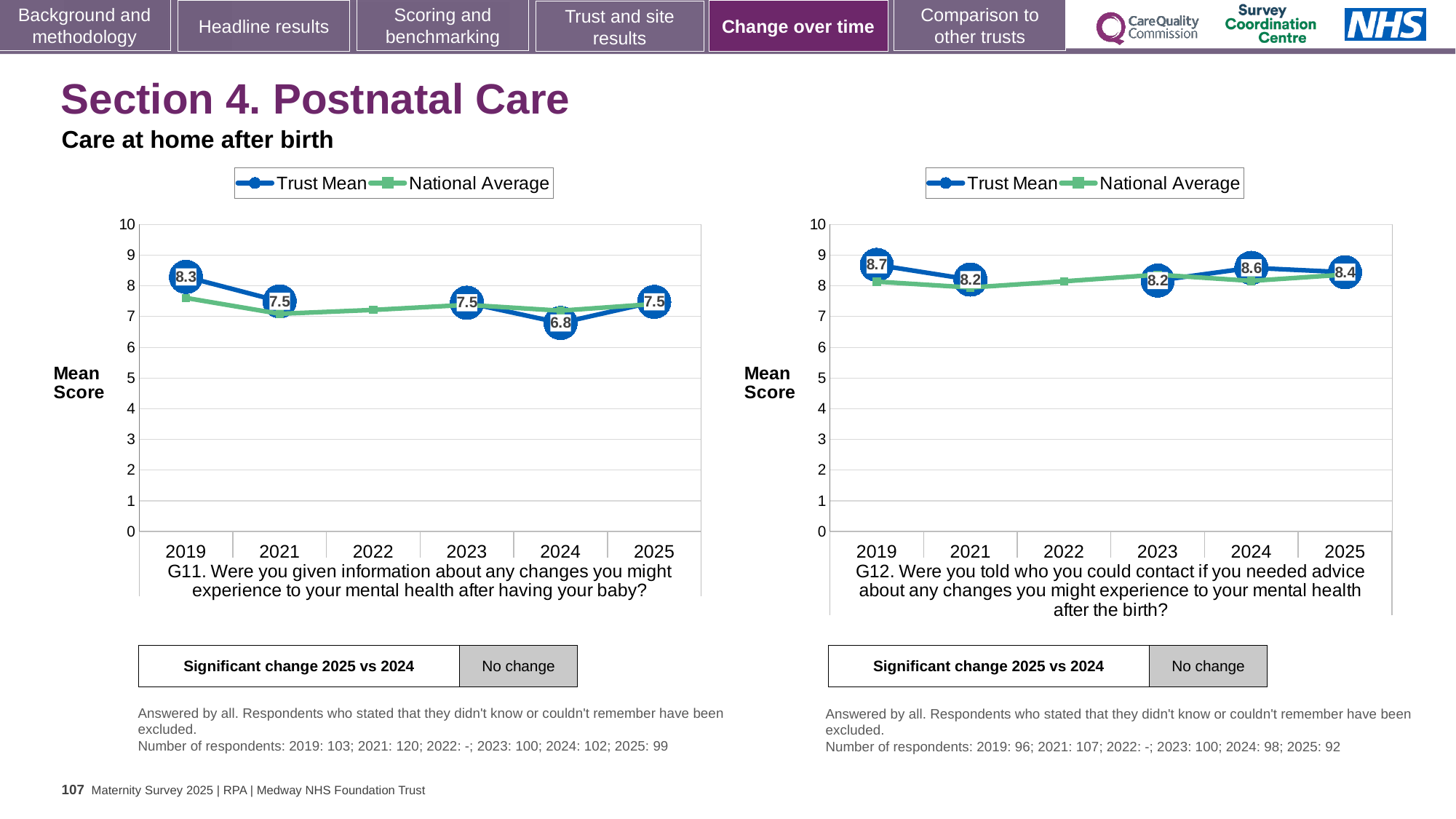
In the G11 chart on the left, what is the Trust Mean score for 2019? 8.3 In the G11 chart on the left, which year has the lowest Trust Mean score? 2024 In the G12 chart on the right, which year has the highest Trust Mean score? 2019 In the G11 chart on the left, what is the difference between the Trust Mean scores for 2019 and 2024? 1.5 How many series does the legend of the G11 chart on the left list? 2 In the G12 chart on the right, what is the difference between the Trust Mean scores for 2024 and 2025? 0.2 In the G12 chart on the right, what is the Trust Mean score for 2019? 8.7 In the G12 chart on the right, is the Trust Mean score for 2024 larger or smaller than the score for 2021? larger What kind of chart is the G12 chart on the right? Line chart In the G12 chart on the right, what is the Trust Mean score for 2025? 8.4 In the G11 chart on the left, is the National Average for 2019 greater or less than 7? greater In the G11 chart on the left, what is the Trust Mean score for 2024? 6.8